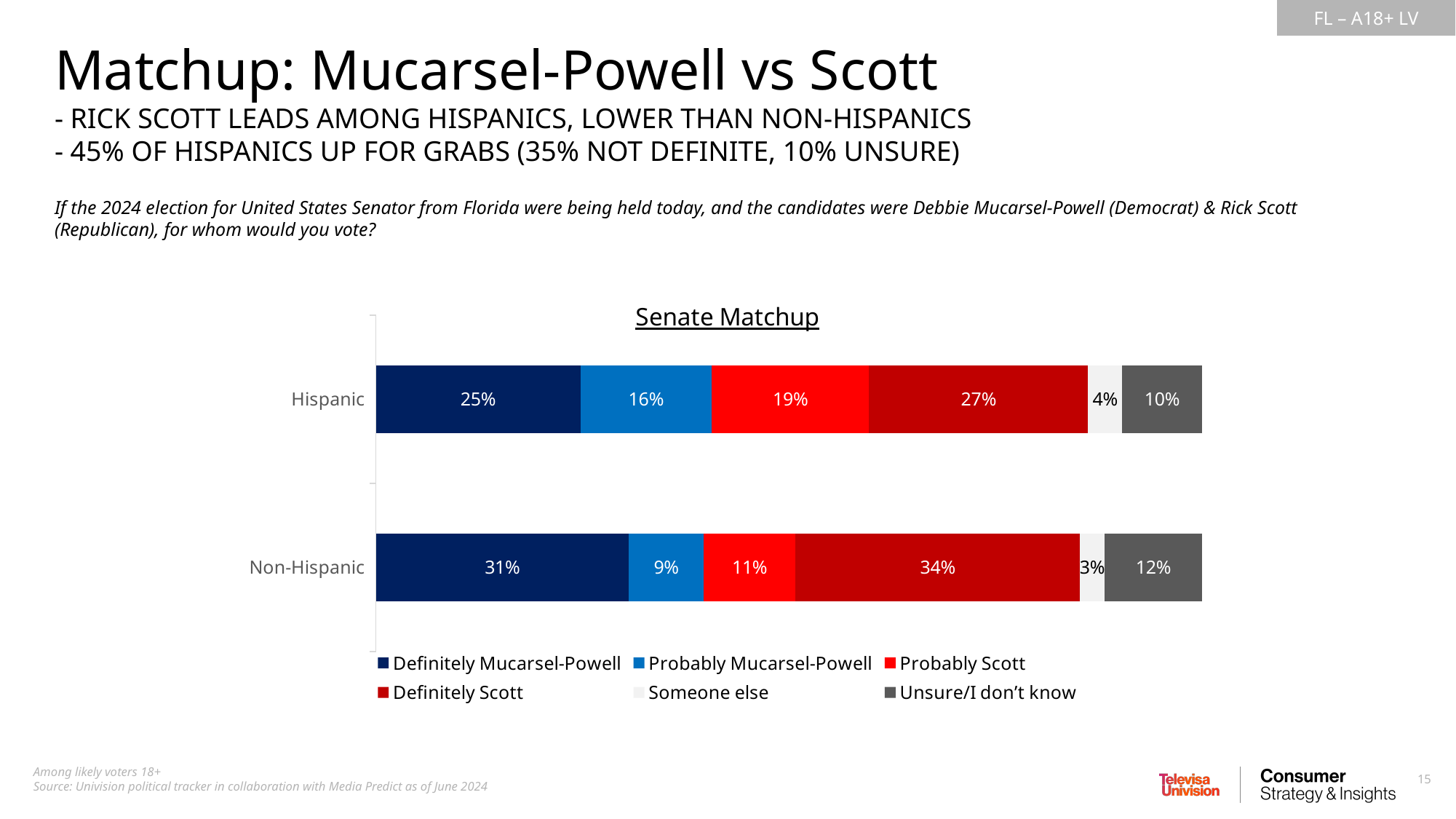
What is the difference between the 'Definitely Scott' values for Non-Hispanic and Hispanic voters? 7% What is the value for 'Probably Scott' among Hispanic voters? 19% What percentage of Hispanic likely voters say they would definitely vote for Mucarsel-Powell? 25% Which response category has the highest value in the Hispanic bar? Definitely Scott What percentage of Non-Hispanic likely voters say they would definitely vote for Scott? 34% What type of chart is the Senate Matchup chart? Stacked bar chart Which group has a larger 'Probably Mucarsel-Powell' value, Hispanic or Non-Hispanic? Hispanic What is the title of the chart? Senate Matchup What is the value for 'Unsure/I don't know' among Non-Hispanic voters? 12% How many series does the legend list? 6 How many groups (bars) are shown in the Senate Matchup chart? 2 Which response category has the lowest value in the Non-Hispanic bar? Someone else